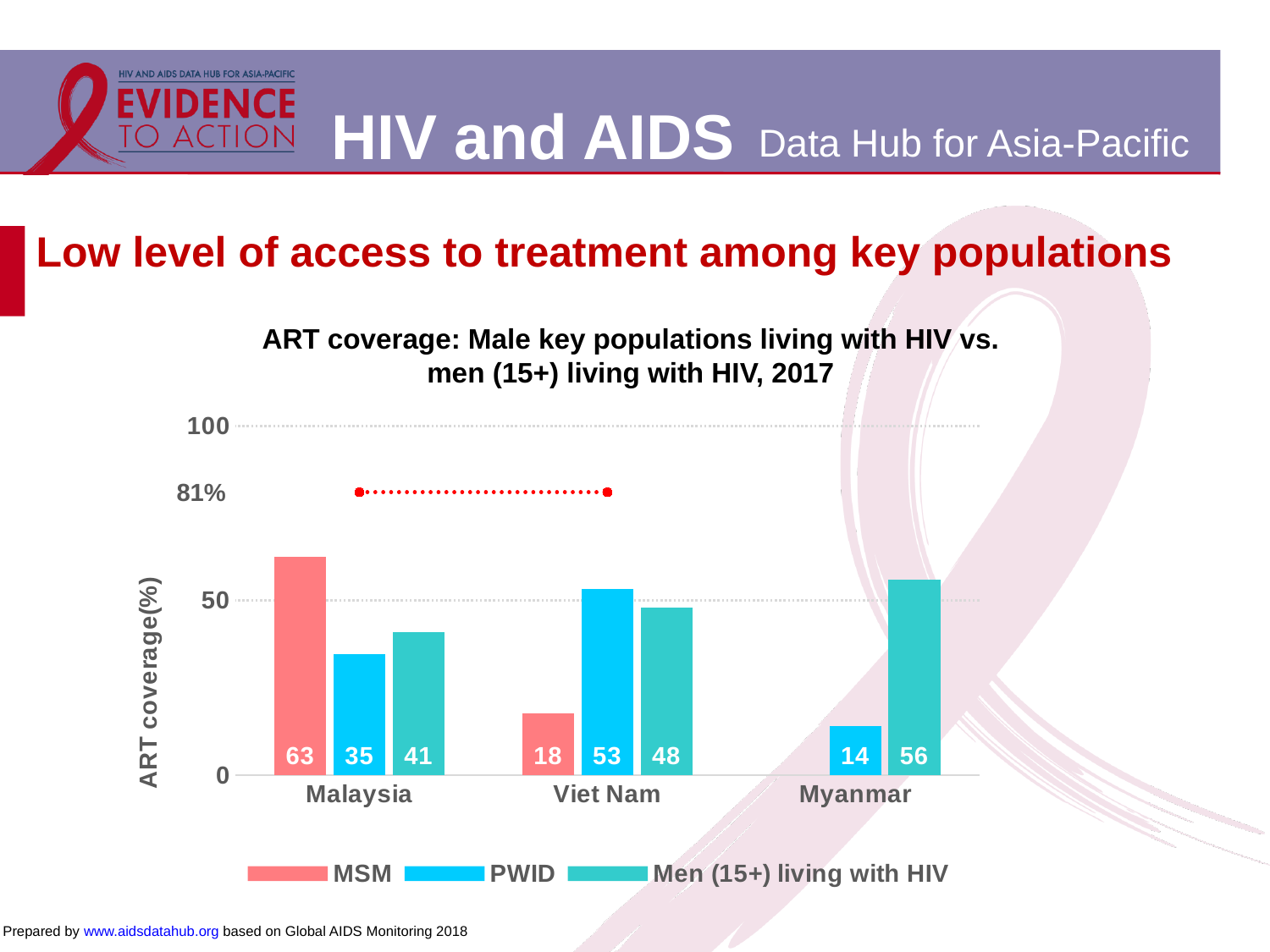
What is the ART coverage for men (15+) living with HIV in Myanmar? 56 What is the ART coverage for PWID in Myanmar? 14 What is the ART coverage for MSM in Malaysia? 63 What is the ART coverage for PWID in Viet Nam? 53 Is the ART coverage for men (15+) living with HIV in Malaysia greater or less than 50? less What kind of chart is shown on the slide? bar chart How many countries are shown on the x axis of the chart? 3 What is the difference between the ART coverage for PWID and MSM in Viet Nam? 35 Which country has the lowest ART coverage for MSM among those with an MSM bar? Viet Nam Which is larger in Malaysia, the ART coverage for MSM or for PWID? MSM How many series does the legend list? 3 Which country has the highest ART coverage for men (15+) living with HIV? Myanmar